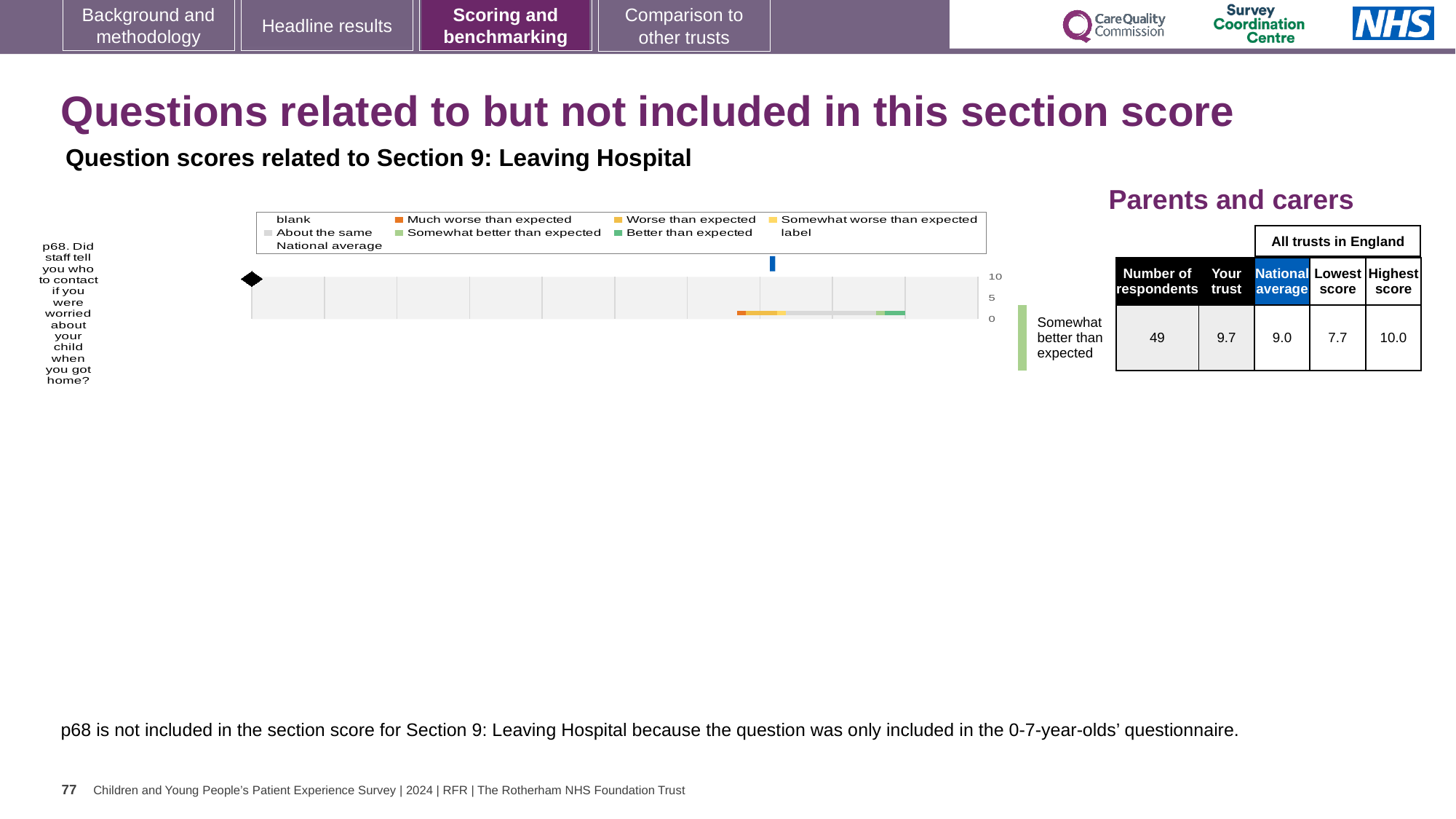
Which question is plotted in the chart? p68. Did staff tell you who to contact if you were worried about your child when you got home? According to the table next to the chart, what is the 'Your trust' score for p68? 9.7 According to the table next to the chart, what is the Lowest score across all trusts in England for p68? 7.7 What is the difference between the 'Your trust' score and the National average for p68? 0.7 How many respondents answered p68 according to the table next to the chart? 49 Which is larger for p68: the 'Your trust' score or the National average? Your trust According to the table next to the chart, what is the National average score for p68? 9.0 According to the table next to the chart, what is the Highest score across all trusts in England for p68? 10.0 How many questions (categories) are plotted in the chart? 1 What kind of chart is shown for question p68? bar chart What benchmark category is the trust's p68 score assigned to, as labelled beside the chart? Somewhat better than expected What is the highest value shown on the chart's axis? 10